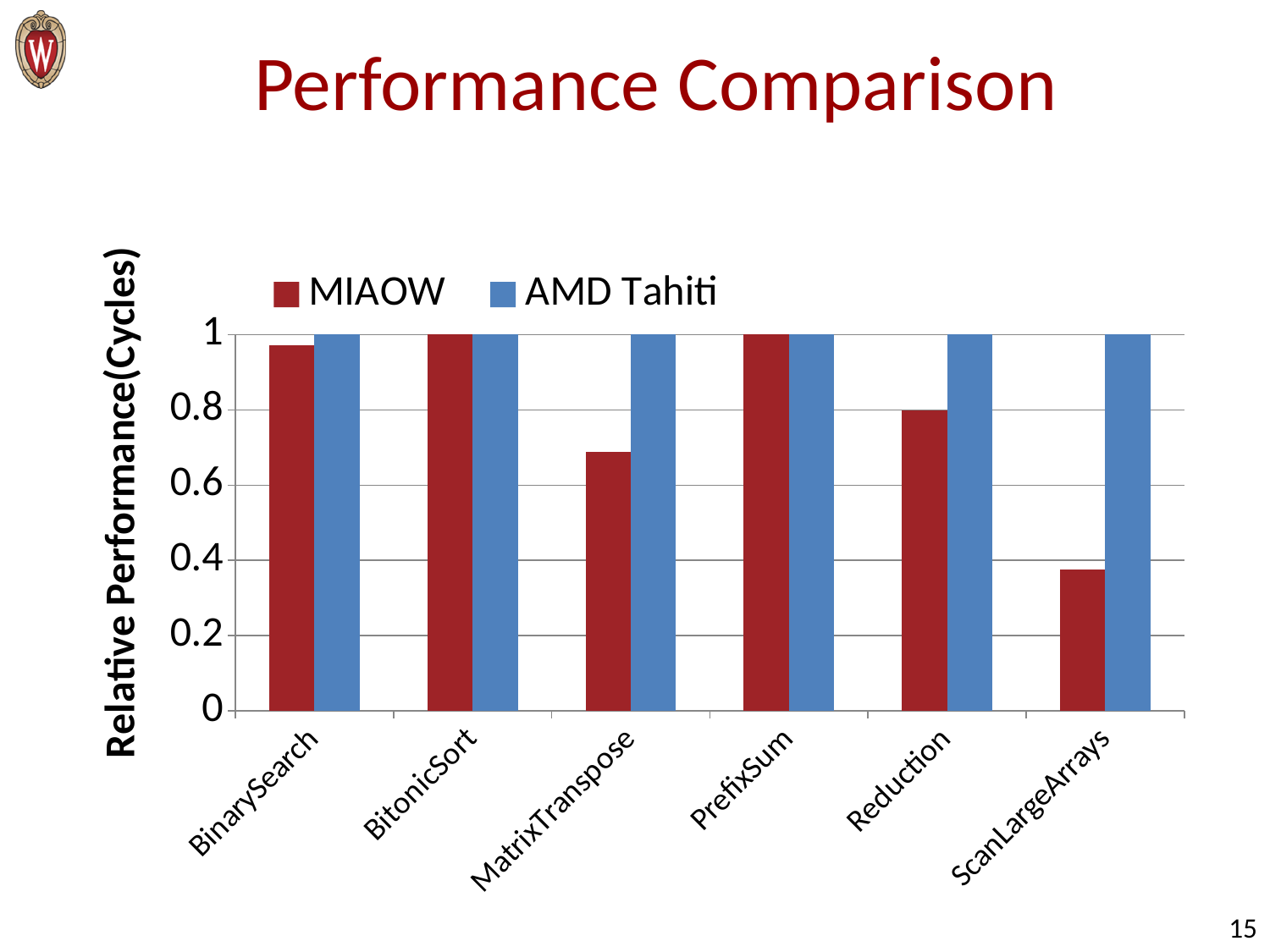
What colour are the MIAOW bars? red Is the MIAOW value for BinarySearch greater or less than 0.8? greater What kind of chart is shown on the slide? bar chart Is the MIAOW value for MatrixTranspose greater or less than 0.8? less What is the title of the y axis? Relative Performance(Cycles) Which benchmark has the lowest MIAOW value? ScanLargeArrays How many series does the legend list? 2 Is the MIAOW value for ScanLargeArrays greater or less than 0.4? less For MatrixTranspose, which series has the larger value, MIAOW or AMD Tahiti? AMD Tahiti How many benchmark categories are shown on the x axis? 6 What is the AMD Tahiti value for Reduction? 1